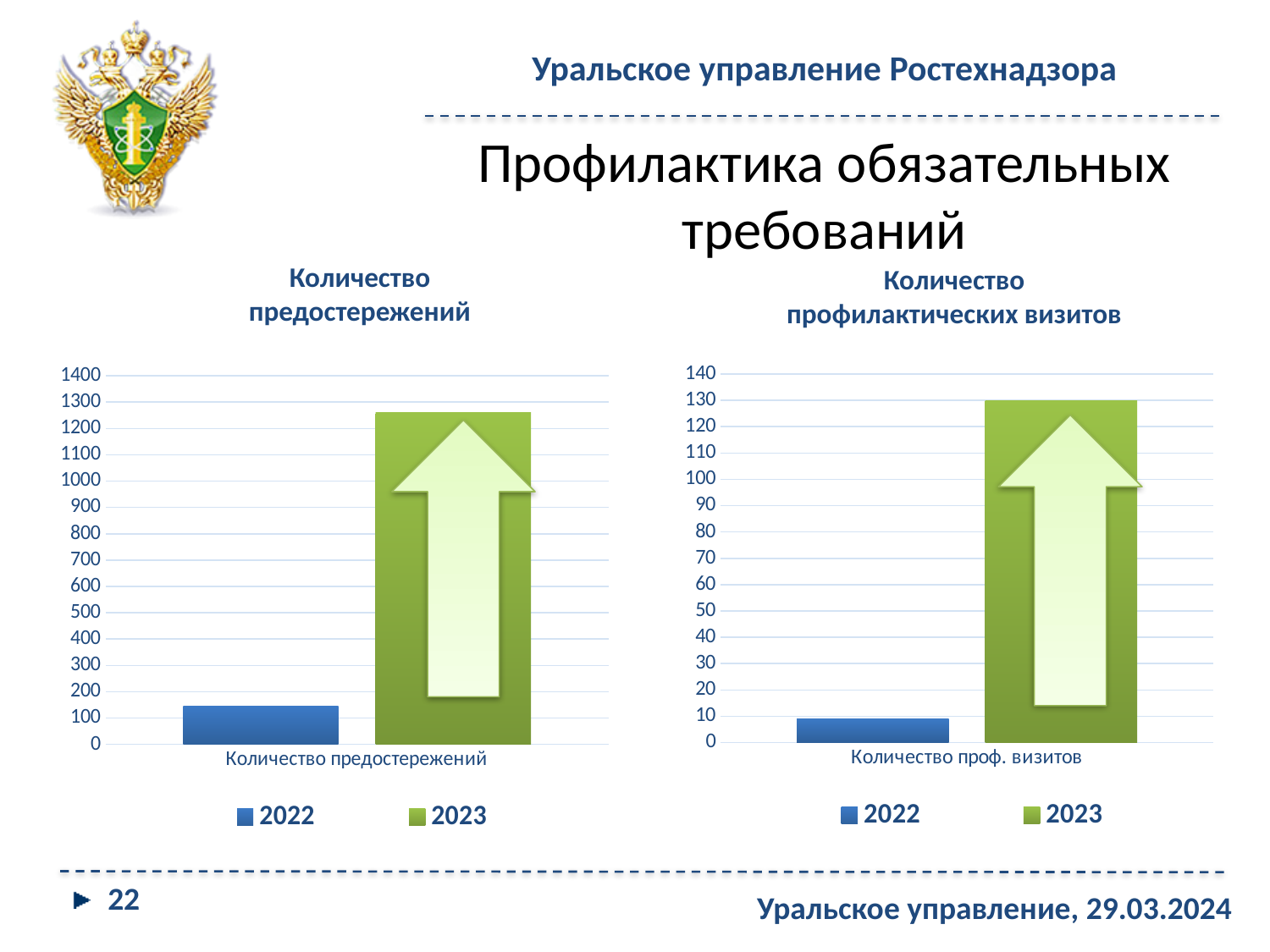
In the 'Количество предостережений' chart, what colour is the bar for the 2022 series? blue In the 'Количество предостережений' chart, is the value for 2022 greater or less than 300? less What kind of chart is the 'Количество профилактических визитов' chart? bar chart In the 'Количество профилактических визитов' chart, which series is larger, 2022 or 2023? 2023 In the 'Количество предостережений' chart, which series has the highest value? 2023 What kind of chart is the 'Количество предостережений' chart? bar chart In the 'Количество предостережений' chart, how many series does the legend list? 2 In the 'Количество профилактических визитов' chart, is the value for 2022 greater or less than 20? less In the 'Количество предостережений' chart, is the value for 2023 greater or less than 1000? greater In the 'Количество профилактических визитов' chart, which series has the lowest value? 2022 What is the title of the chart on the right side of the slide? Количество профилактических визитов